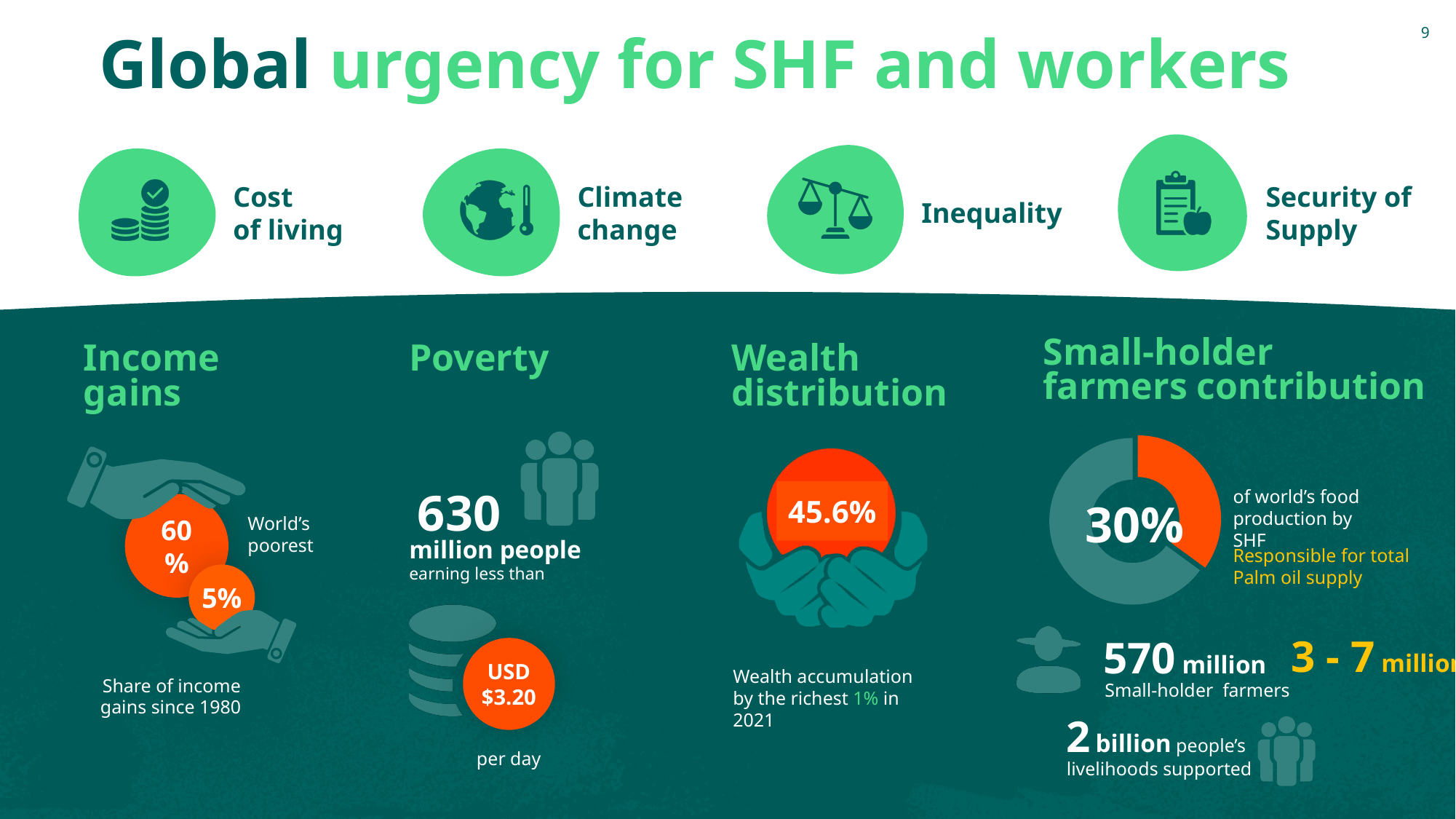
What kind of chart is shown under the 'Small-holder farmers contribution' heading? Donut (pie) chart In the donut chart under 'Small-holder farmers contribution', is the highlighted slice greater or less than 50% of the donut? less In the donut chart under 'Small-holder farmers contribution', what percentage is shown for the highlighted orange slice? 30% In the donut chart under 'Small-holder farmers contribution', which slice is larger: the orange highlighted slice or the teal remainder? The teal remainder In the donut chart under 'Small-holder farmers contribution', what colour is the slice labelled 30%? Orange In the donut chart under 'Small-holder farmers contribution', how many slices does the donut have? 2 In the donut chart under 'Small-holder farmers contribution', what share of the donut is not covered by the 30% slice? 70% In the donut chart under 'Small-holder farmers contribution', what does the 30% slice represent? Share of world's food production by SHF